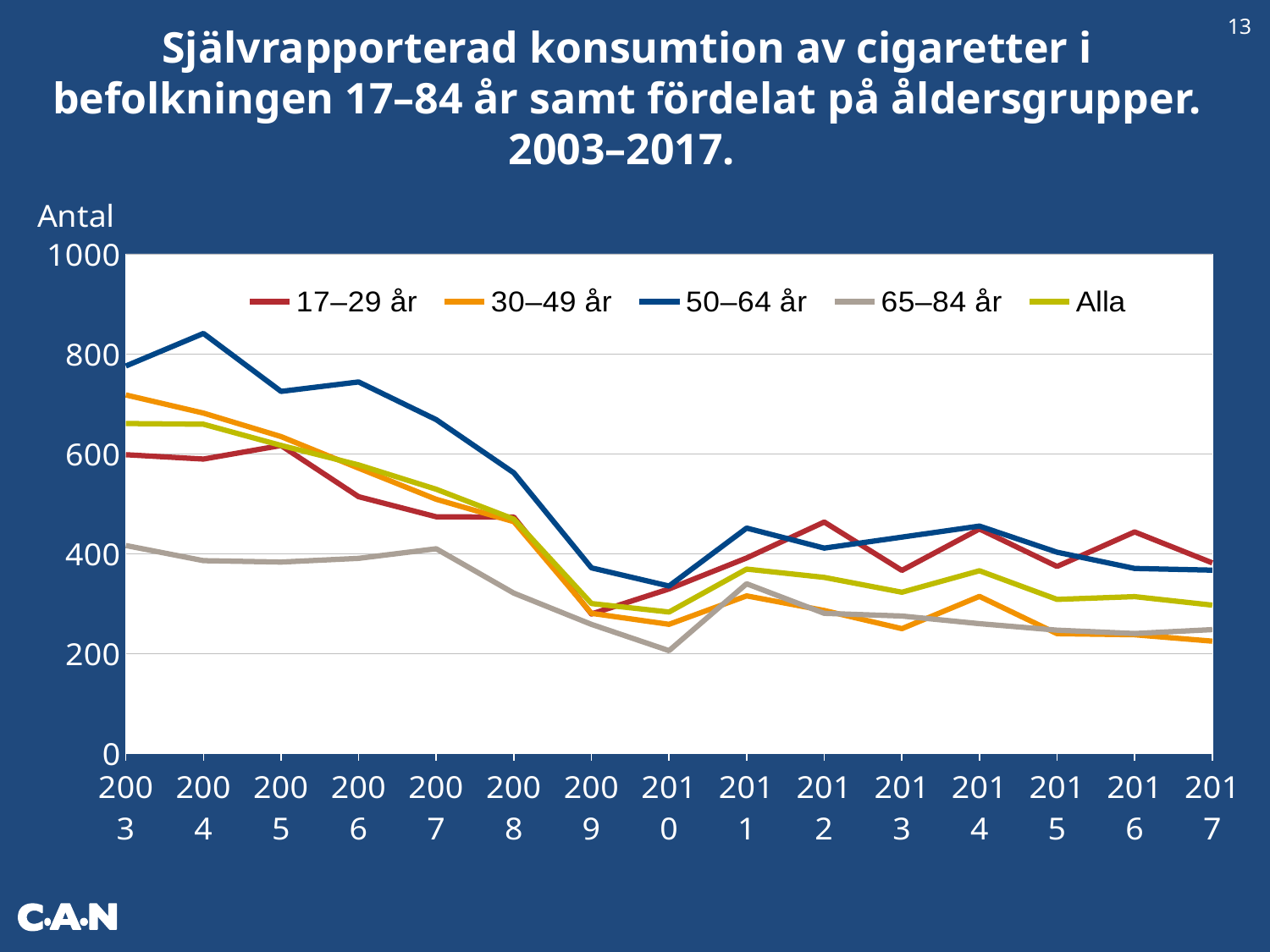
Does the 50–64 år line rise or fall from 2003 to 2009? fall Which age group has the highest value in 2012? 17–29 år Which age group has the highest value in 2004? 50–64 år What is the label on the y axis? Antal How many series does the legend list? 5 Is the value for 50–64 år in 2004 greater or less than 800? greater Is the value for 30–49 år in 2003 greater or less than 600? greater In 2003, which is higher: 30–49 år or 17–29 år? 30–49 år What kind of chart is shown on the slide? line chart Which age group has the lowest value in 2003? 65–84 år Is the value for 30–49 år in 2017 greater or less than 400? less How many years are plotted along the x axis? 15